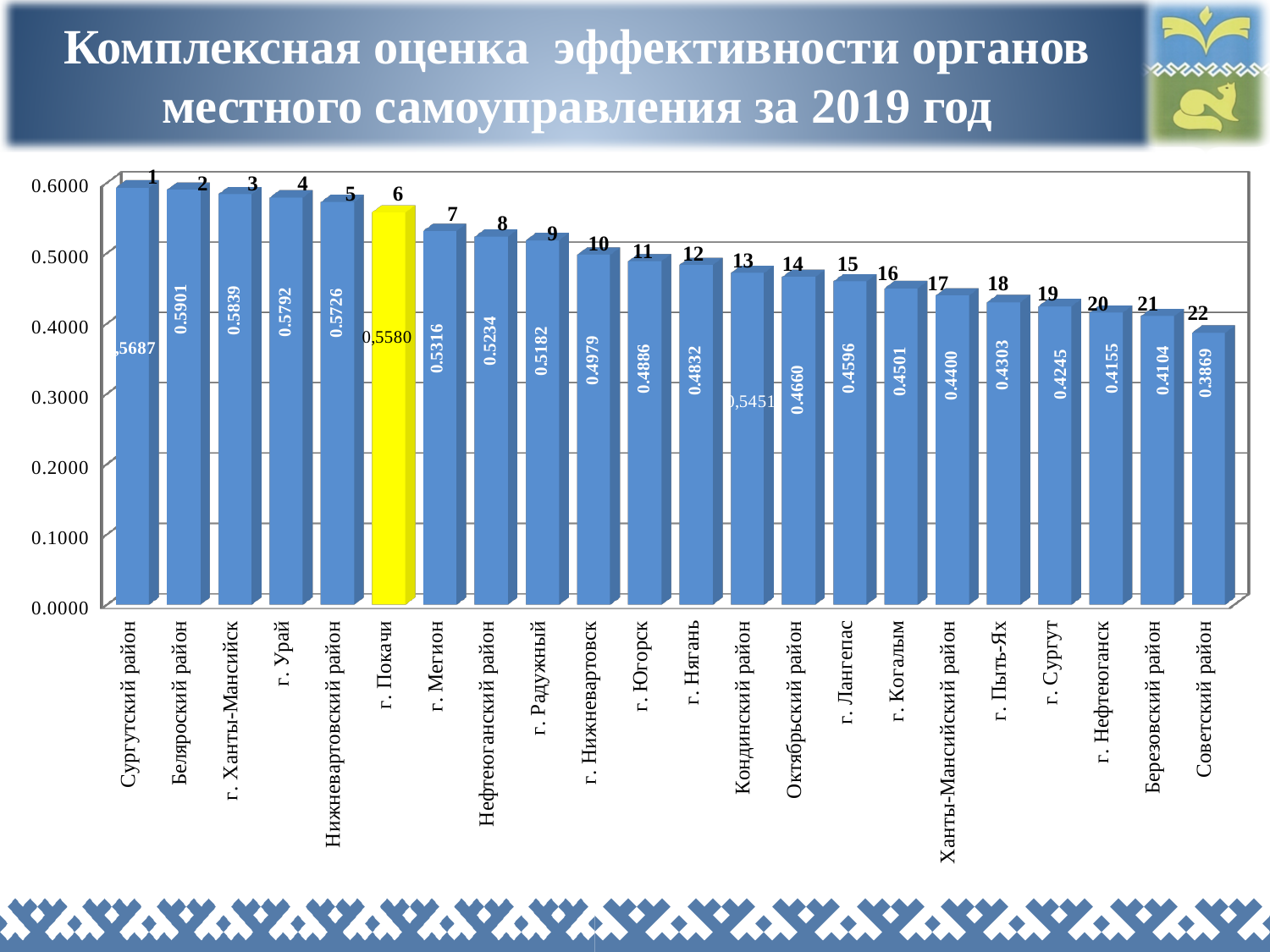
Is the value for г. Сургут greater or less than 0.5000? less What is the value for г. Мегион? 0.5316 Which category's bar is highlighted in yellow? г. Покачи Which category has the lowest value? Советский район What is the difference between the values for г. Урай and г. Нижневартовск? 0.0813 Which category has the tallest bar? Сургутский район What kind of chart is shown on the slide? bar chart What is the value for г. Покачи? 0,5580 How many categories are shown on the chart? 22 What is the value for г. Когалым? 0.4501 Which has the larger value, г. Югорск or г. Нягань? г. Югорск What is the value for Советский район? 0.3869